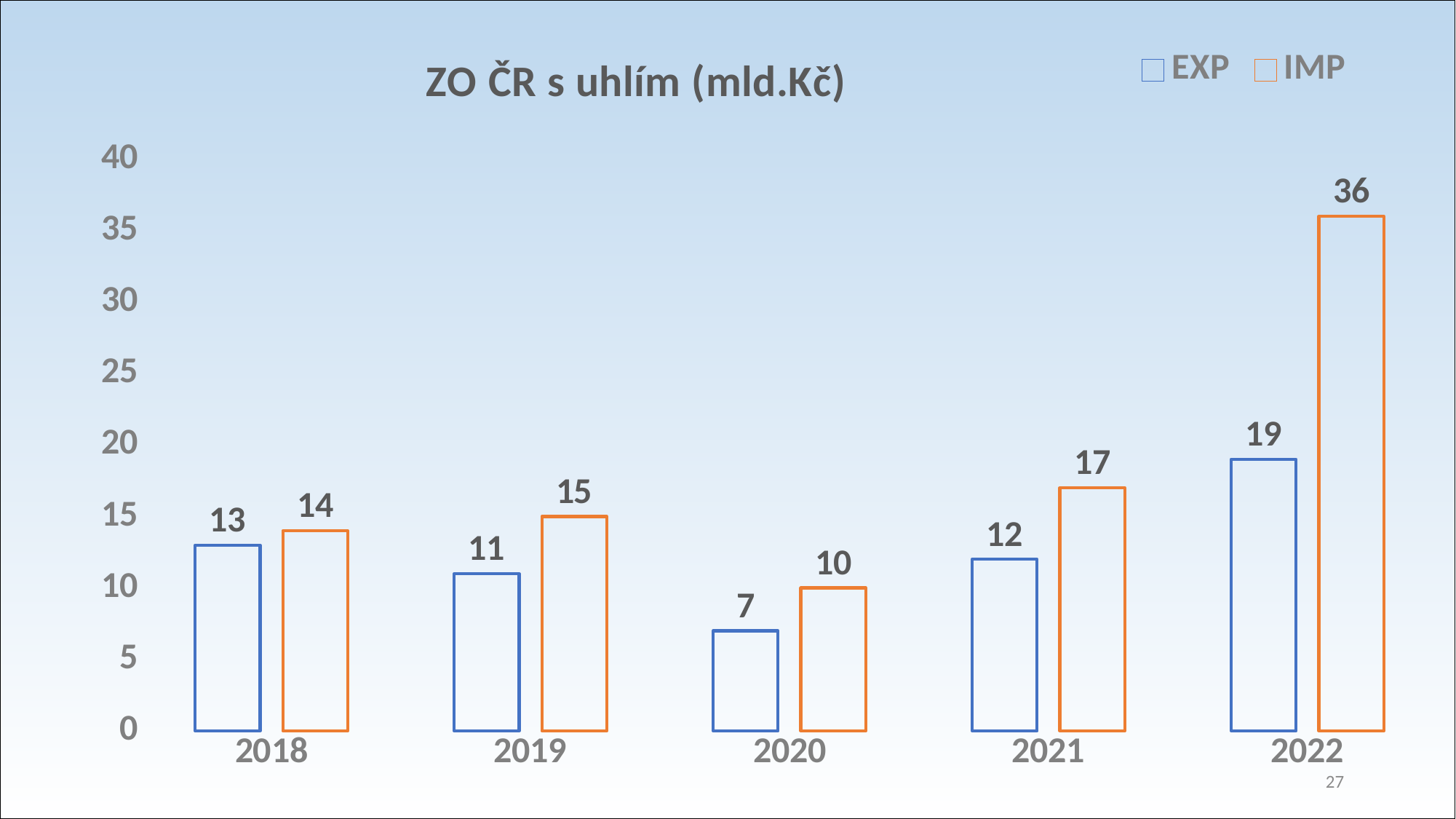
How many years are shown on the x axis? 5 What is the difference between EXP in 2021 and EXP in 2020? 5 Which year has the lowest EXP value? 2020 What kind of chart is shown? bar chart What is the IMP value for 2022? 36 What is the IMP value for 2019? 15 How many series does the legend list? 2 What is the title of the chart? ZO ČR s uhlím (mld.Kč) What is the EXP value for 2020? 7 Which is larger in 2018, EXP or IMP? IMP What is the difference between IMP and EXP in 2022? 17 Which year has the highest IMP value? 2022